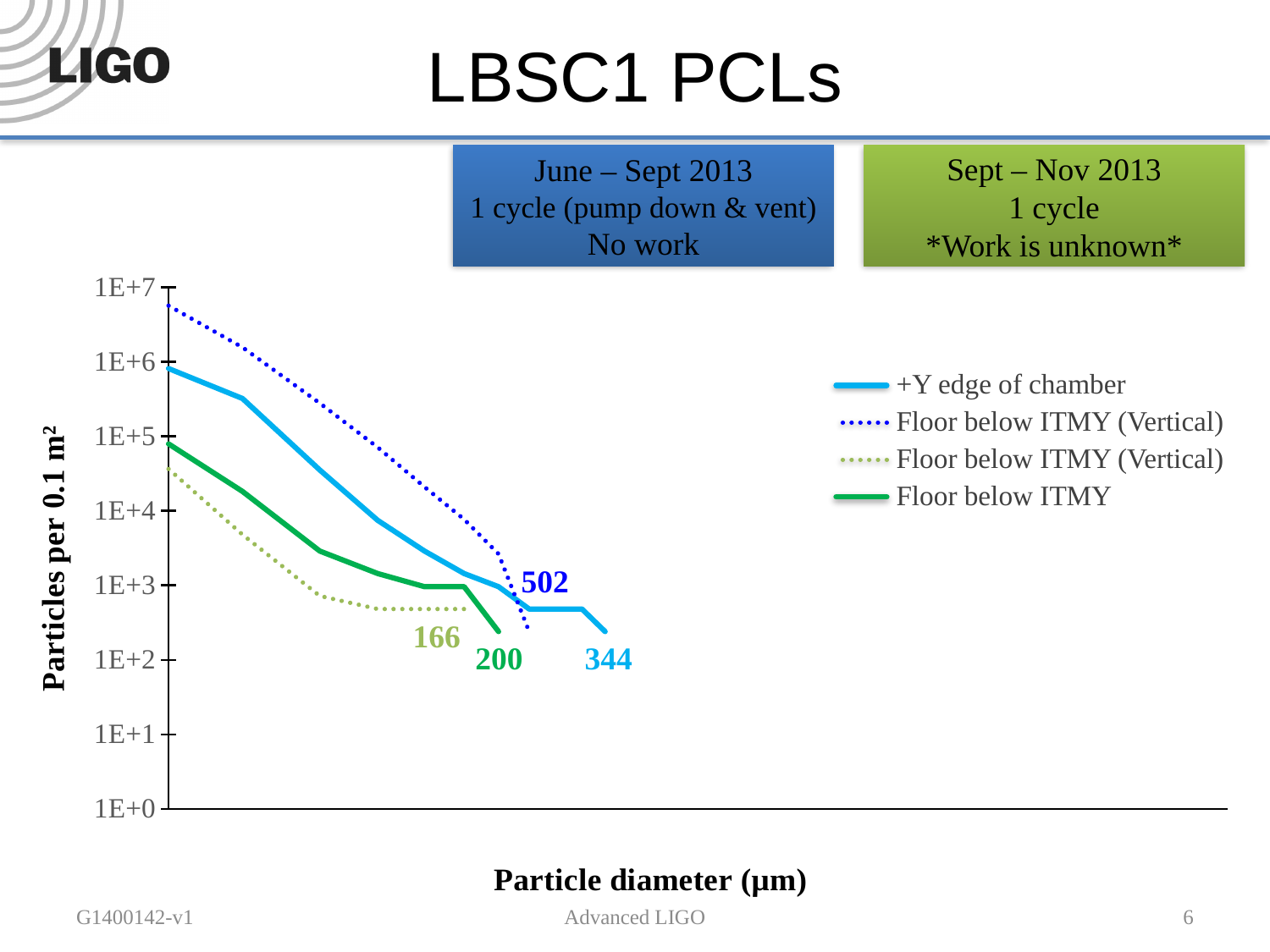
What is the title of the chart's y axis? Particles per 0.1 m² Which series starts at the highest particle count at the left of the chart? Floor below ITMY (Vertical) (dark blue dotted line) What is the difference between the end labels of the dark blue dotted line (502) and the +Y edge of chamber line (344)? 158 What kind of chart is shown on the slide? line chart What number is labelled at the end of the light green dotted Floor below ITMY (Vertical) line? 166 What number is labelled at the end of the solid green Floor below ITMY line? 200 What number is labelled at the end of the +Y edge of chamber line? 344 Is the starting value of the light green dotted Floor below ITMY (Vertical) line greater or less than 1E+5? less What number is labelled at the end of the dark blue dotted Floor below ITMY (Vertical) line? 502 What is the title of the chart's x axis? Particle diameter (µm) Do the plotted values rise or fall as particle diameter increases along the x axis? fall How many series does the chart legend list? 4